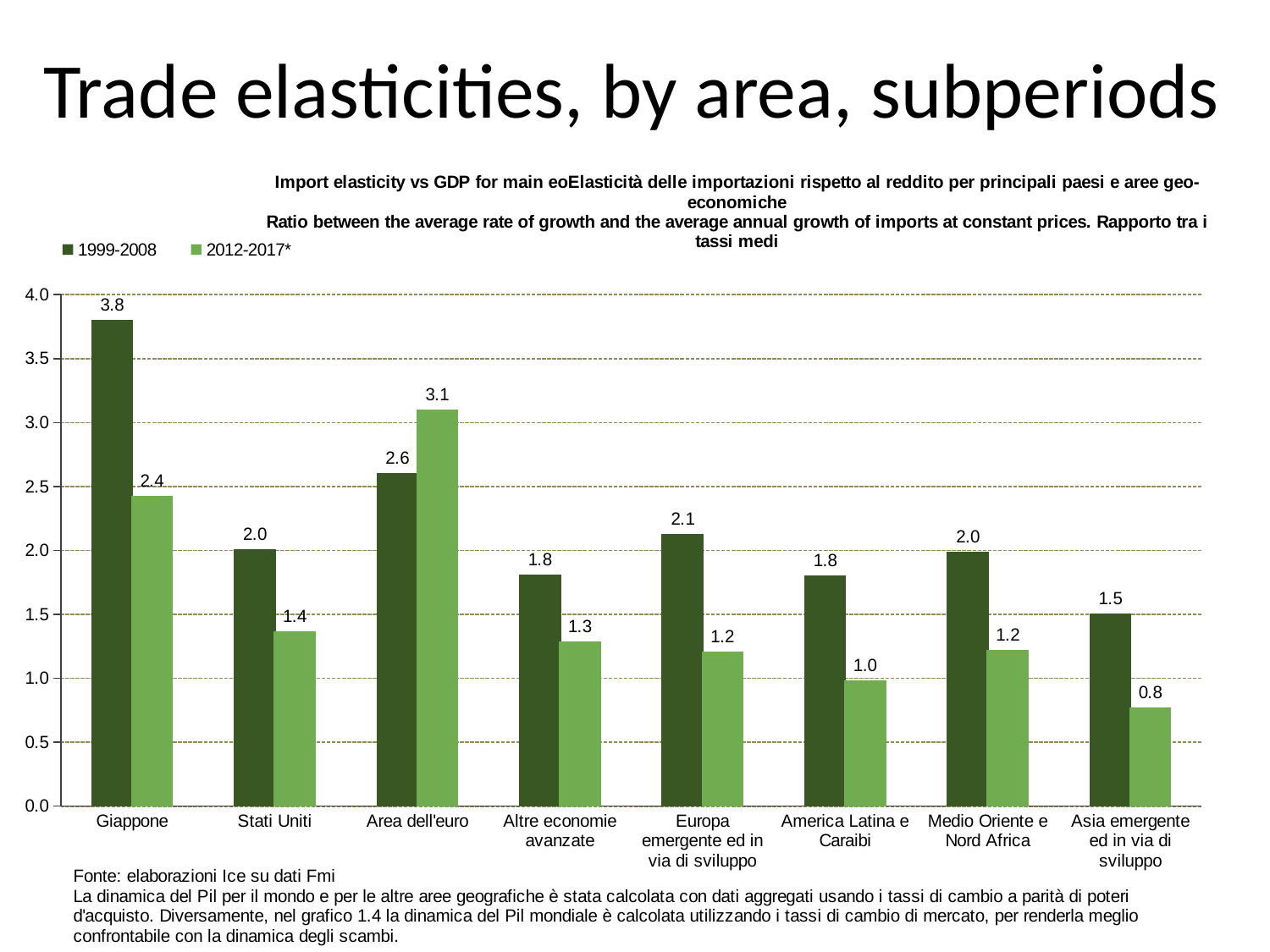
What is the difference between the 1999-2008 and 2012-2017* values for Giappone? 1.4 What is the value for Giappone in the 1999-2008 series? 3.8 How many series does the legend list? 2 Is the 1999-2008 value for Stati Uniti greater or less than 1.5? greater Which series is shown in the darker green colour? 1999-2008 What kind of chart is shown on the slide? bar chart How many categories are shown on the x axis? 8 For Area dell'euro, which series has the larger value, 1999-2008 or 2012-2017*? 2012-2017* What is the value for Area dell'euro in the 2012-2017* series? 3.1 Which category has the highest value in the 1999-2008 series? Giappone Which category has the lowest value in the 2012-2017* series? Asia emergente ed in via di sviluppo What is the value for America Latina e Caraibi in the 2012-2017* series? 1.0